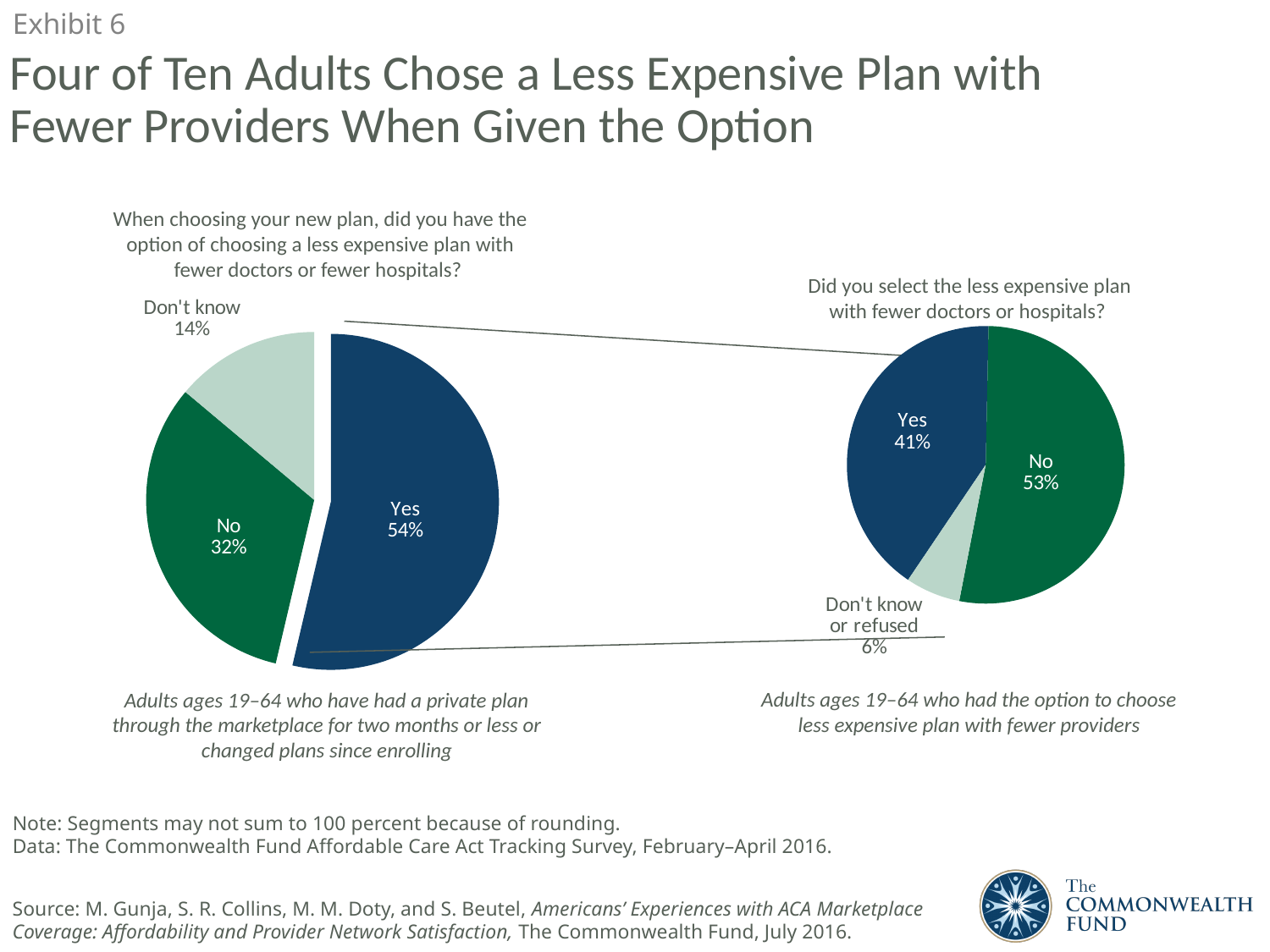
In the right pie chart, what percentage answered No? 53% In the right pie chart, what percentage answered Don't know or refused? 6% What type of chart is used on this slide? Pie chart In the right pie chart, what share of adults said Yes to selecting the less expensive plan with fewer doctors or hospitals? 41% In the left pie chart, what share of adults answered Yes to having the option of a less expensive plan with fewer doctors or hospitals? 54% In the right pie chart, which response has the smallest share? Don't know or refused In the left pie chart, which is larger, the No share or the Don't know share? No In the left pie chart, what percentage answered No? 32% How many segments does the right pie chart have? 3 In the left pie chart, what percentage answered Don't know? 14% In the right pie chart, what is the difference between the No and Yes shares? 12 percentage points In the left pie chart, which response has the largest share? Yes